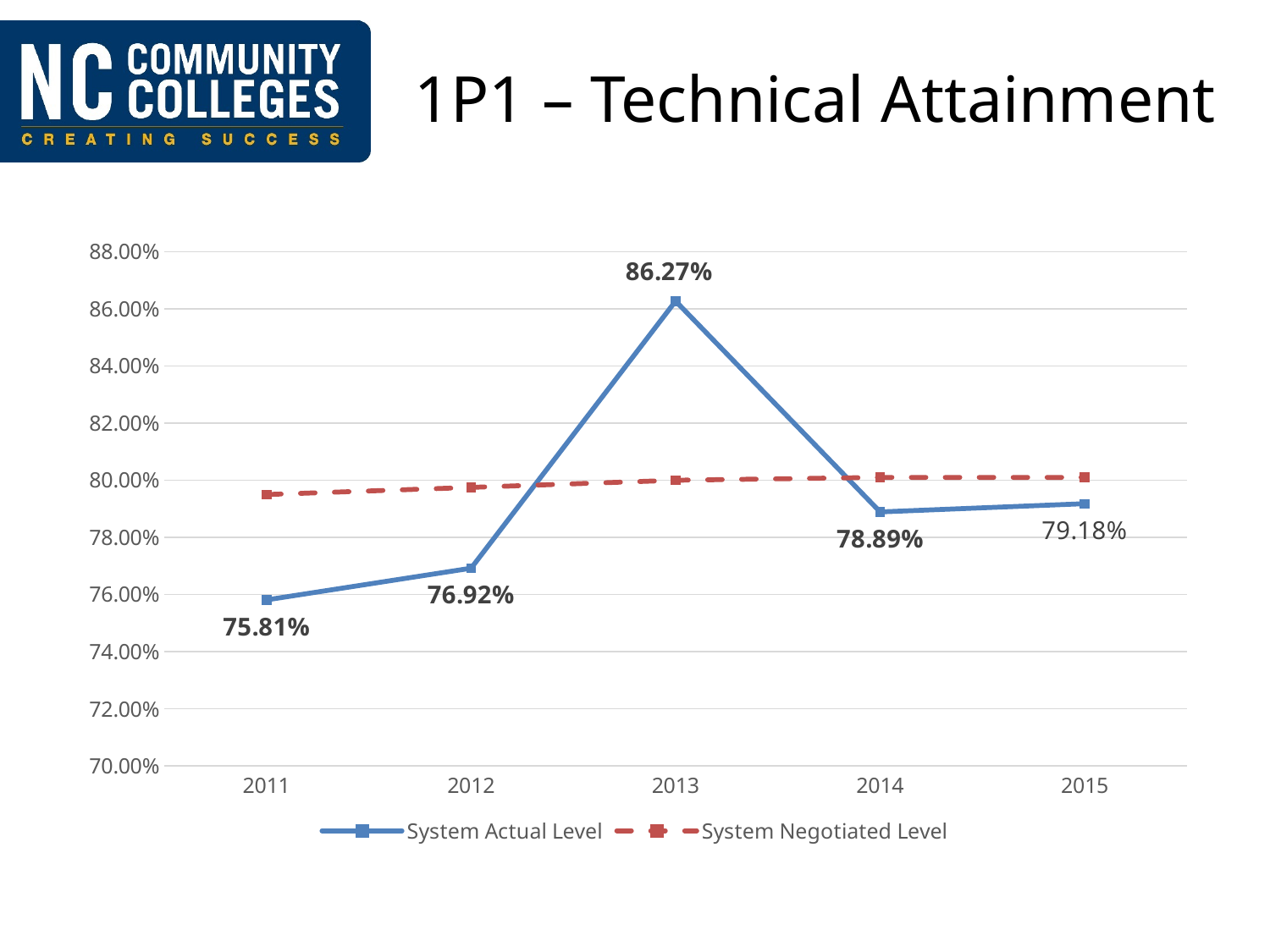
Does the System Actual Level rise or fall from 2011 to 2013? rise Is the System Negotiated Level for 2011 greater or less than 80.00%? less What is the difference between the System Actual Level in 2013 and in 2014? 7.38% In which year is the System Actual Level lowest? 2011 How many series does the legend list? 2 What kind of chart is shown on the slide? line chart What is the System Actual Level for 2015? 79.18% In which year is the System Actual Level highest? 2013 What is the System Actual Level for 2011? 75.81% How many years are shown on the x axis? 5 Which is larger, the System Actual Level in 2012 or in 2015? 2015 What is the System Actual Level for 2013? 86.27%